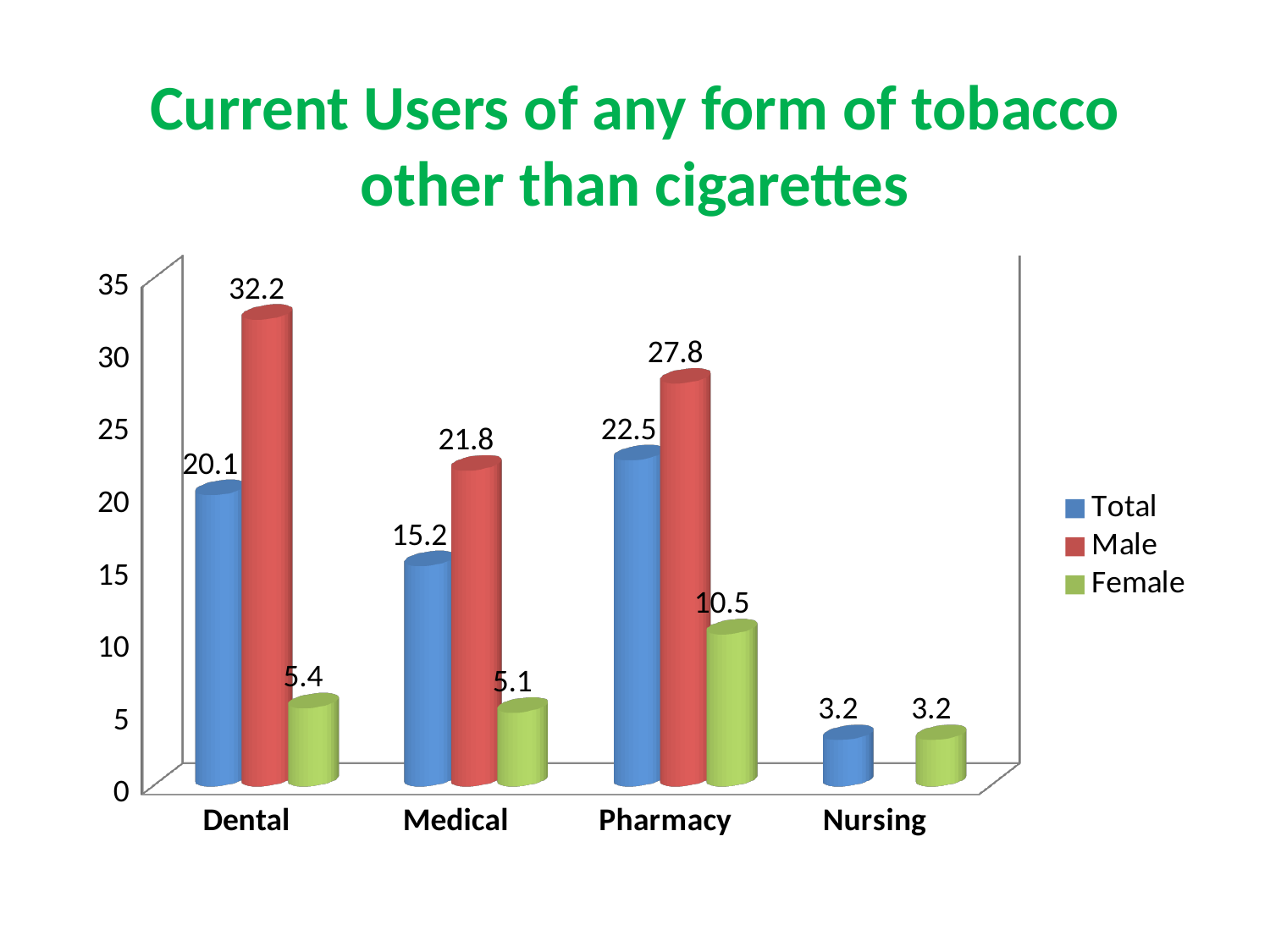
What kind of chart is shown on the slide? Bar chart Which is larger, the Total value for Dental or the Total value for Pharmacy? Pharmacy Which category has the highest Male value? Dental Which category has the lowest Total value? Nursing What is the Female value for Medical? 5.1 What is the Male value for Dental? 32.2 What is the Total value for Pharmacy? 22.5 How many series does the legend list? 3 What is the title of the chart? Current Users of any form of tobacco other than cigarettes How many categories are shown on the x axis? 4 What is the difference between the Male and Female values for Pharmacy? 17.3 Which series is shown in red in the legend? Male